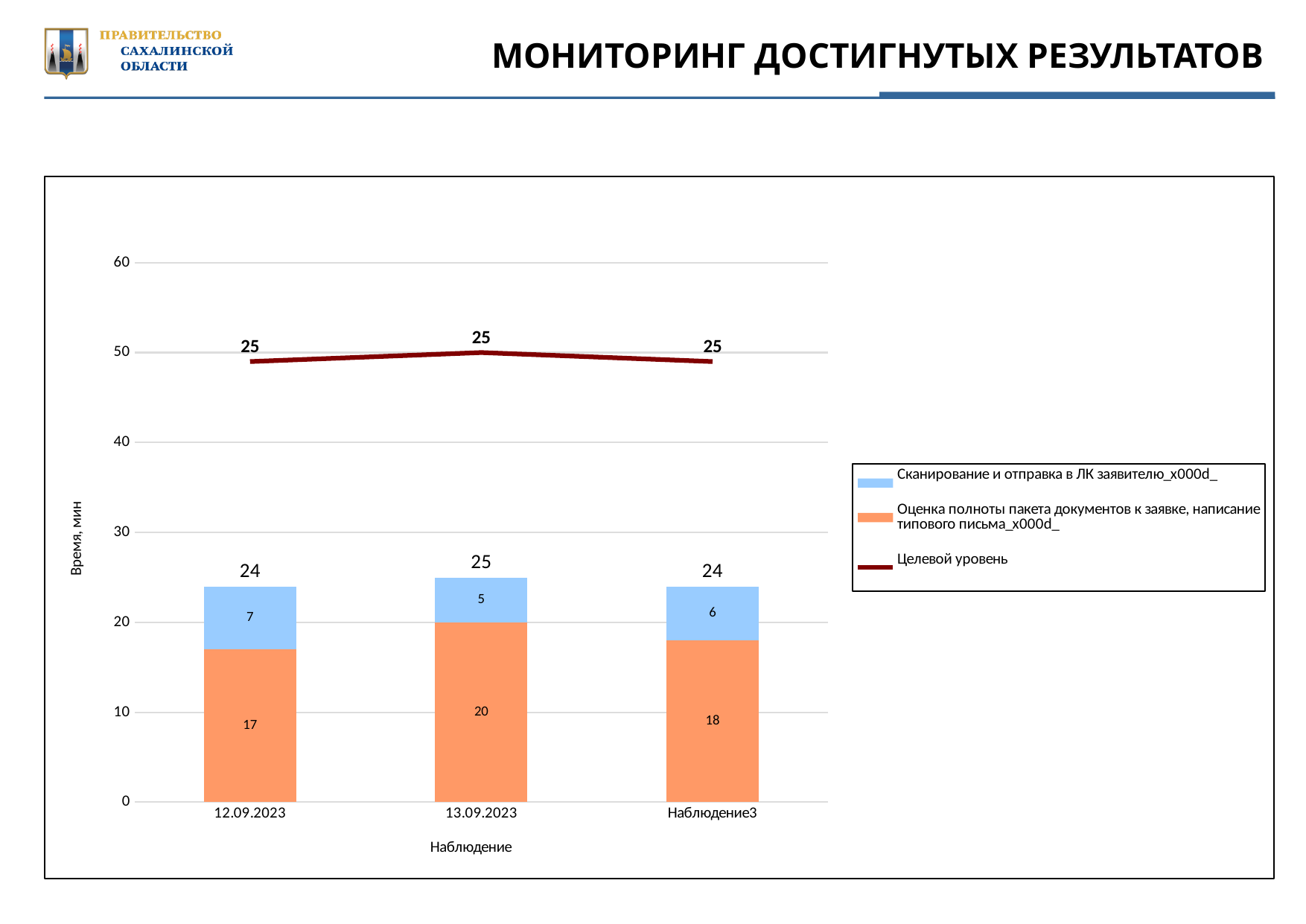
What is the value of the 'Оценка полноты пакета документов к заявке, написание типового письма' segment for 13.09.2023? 20 What is the value of the 'Сканирование и отправка в ЛК заявителю' segment for 12.09.2023? 7 What is the total of the stacked bar for 13.09.2023? 25 What is the label on the y axis? Время, мин How many categories are shown on the x axis? 3 Which category has the lowest value for the 'Сканирование и отправка в ЛК заявителю' series? 13.09.2023 Which category has the highest value for the 'Оценка полноты пакета документов к заявке, написание типового письма' series? 13.09.2023 Which is larger: the 'Сканирование и отправка в ЛК заявителю' value for 12.09.2023 or for Наблюдение3? 12.09.2023 What is the difference between the 'Оценка полноты пакета документов' values for 13.09.2023 and 12.09.2023? 3 What is the value of the 'Сканирование и отправка в ЛК заявителю' segment for Наблюдение3? 6 How many series does the legend list? 3 What is the total of the stacked bar for 12.09.2023? 24